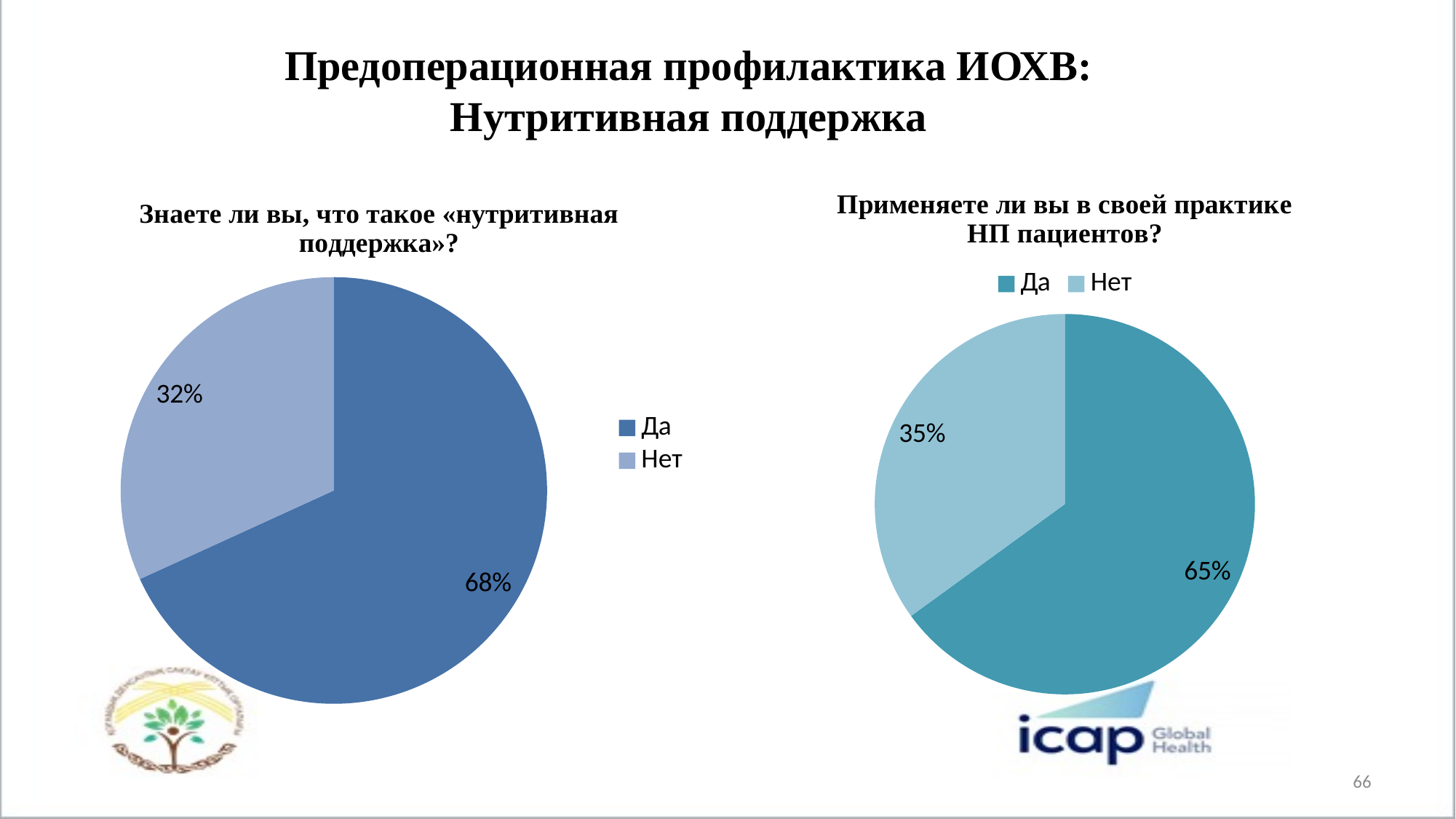
How many slices does the left pie chart have? 2 In the right chart ("Применяете ли вы в своей практике НП пациентов?"), what percentage answered "Нет"? 35% In the left chart ("Знаете ли вы, что такое «нутритивная поддержка»?"), what percentage answered "Нет"? 32% In the right chart, which answer has the smallest share? Нет In the left chart, which answer has the largest share? Да How many entries does the legend of the right chart list? 2 In the left chart, what is the difference between the "Да" and "Нет" shares? 36% Is the "Да" share larger in the left chart or in the right chart? Left chart In the right chart, what is the difference between the "Да" and "Нет" shares? 30% In the right chart ("Применяете ли вы в своей практике НП пациентов?"), what percentage answered "Да"? 65% What type of chart is used on the right side of the slide? Pie chart In the left chart ("Знаете ли вы, что такое «нутритивная поддержка»?"), what percentage answered "Да"? 68%